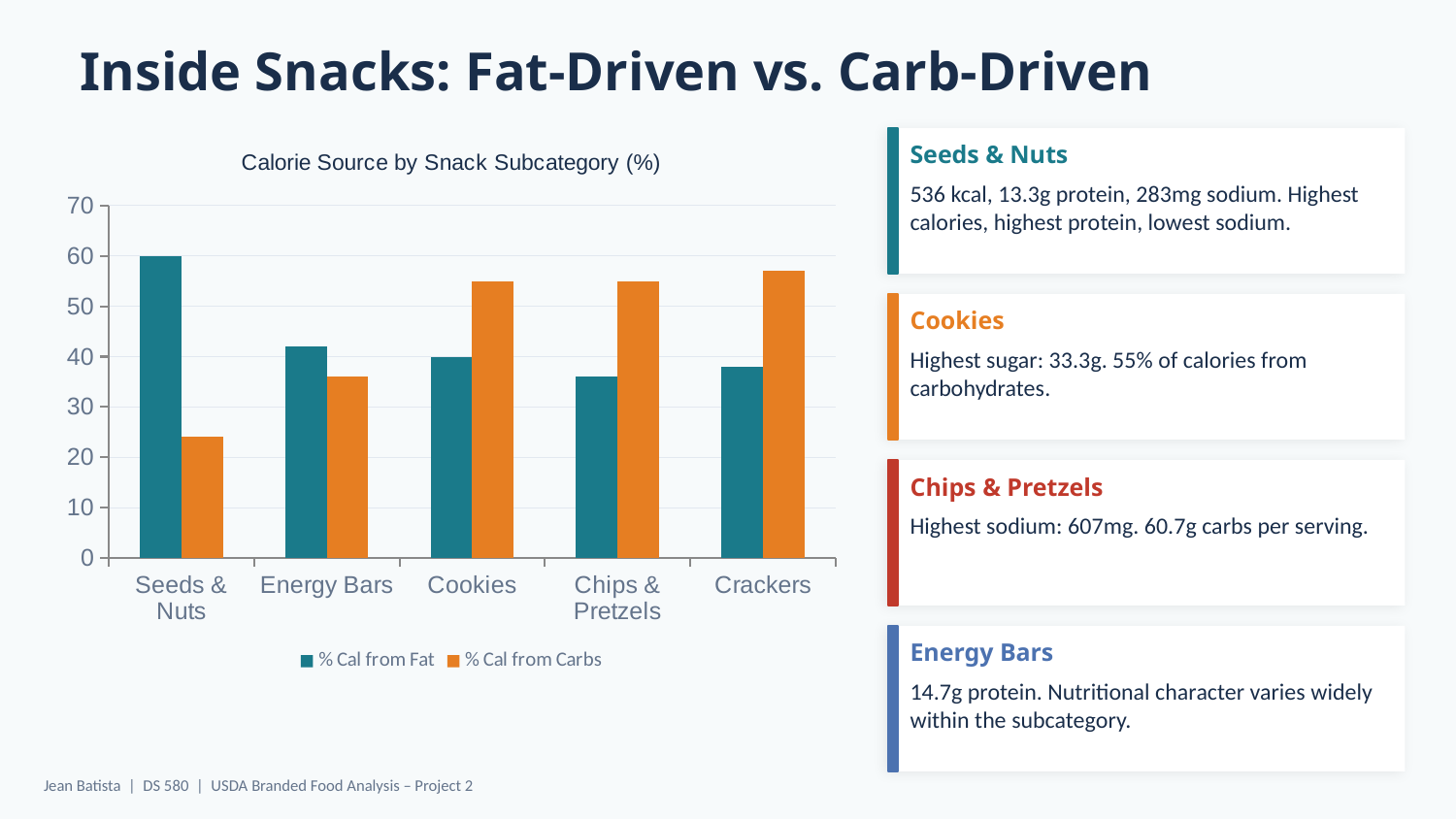
Which snack subcategory has the lowest % Cal from Carbs? Seeds & Nuts What is the % Cal from Fat for Seeds & Nuts? 60 Is the % Cal from Carbs for Seeds & Nuts greater or less than 30? less How many snack subcategories are shown on the x axis? 5 For Seeds & Nuts, which is larger: % Cal from Fat or % Cal from Carbs? % Cal from Fat Is the % Cal from Carbs for Crackers greater or less than 50? greater Which snack subcategory has the highest % Cal from Fat? Seeds & Nuts For Cookies, which is larger: % Cal from Fat or % Cal from Carbs? % Cal from Carbs What is the title of the chart? Calorie Source by Snack Subcategory (%) How many series does the chart legend list? 2 What kind of chart is shown on the slide? bar chart Is the % Cal from Fat for Energy Bars greater or less than 40? greater